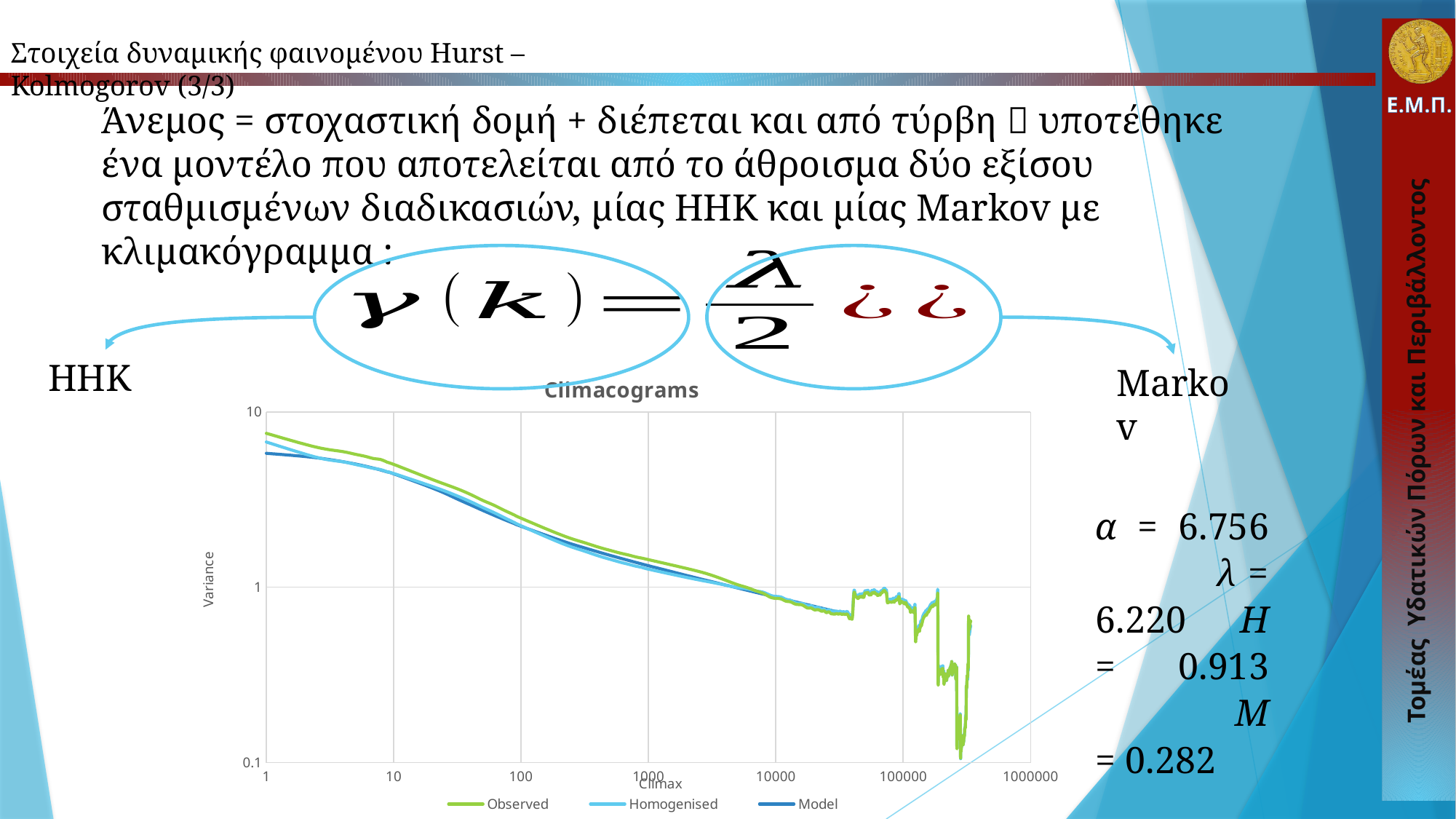
How many series does the legend of the Climacograms chart list? 3 What are the series names listed in the legend of the Climacograms chart? Observed, Homogenised, Model What kind of chart is the Climacograms chart? line chart What is the title of the chart on the slide? Climacograms In the Climacograms chart, which series has the highest value at x = 1? Observed Do the values in the Climacograms chart generally rise or fall as the x axis increases? fall In the Climacograms chart, is the Observed value at x = 1 greater or less than 10? less In the Climacograms chart, is the Model value at x = 10 greater or less than 1? greater In the Climacograms chart, which series has the higher value at x = 1, Observed or Model? Observed In the Climacograms chart, is the Observed value at x = 1 greater or less than 1? greater